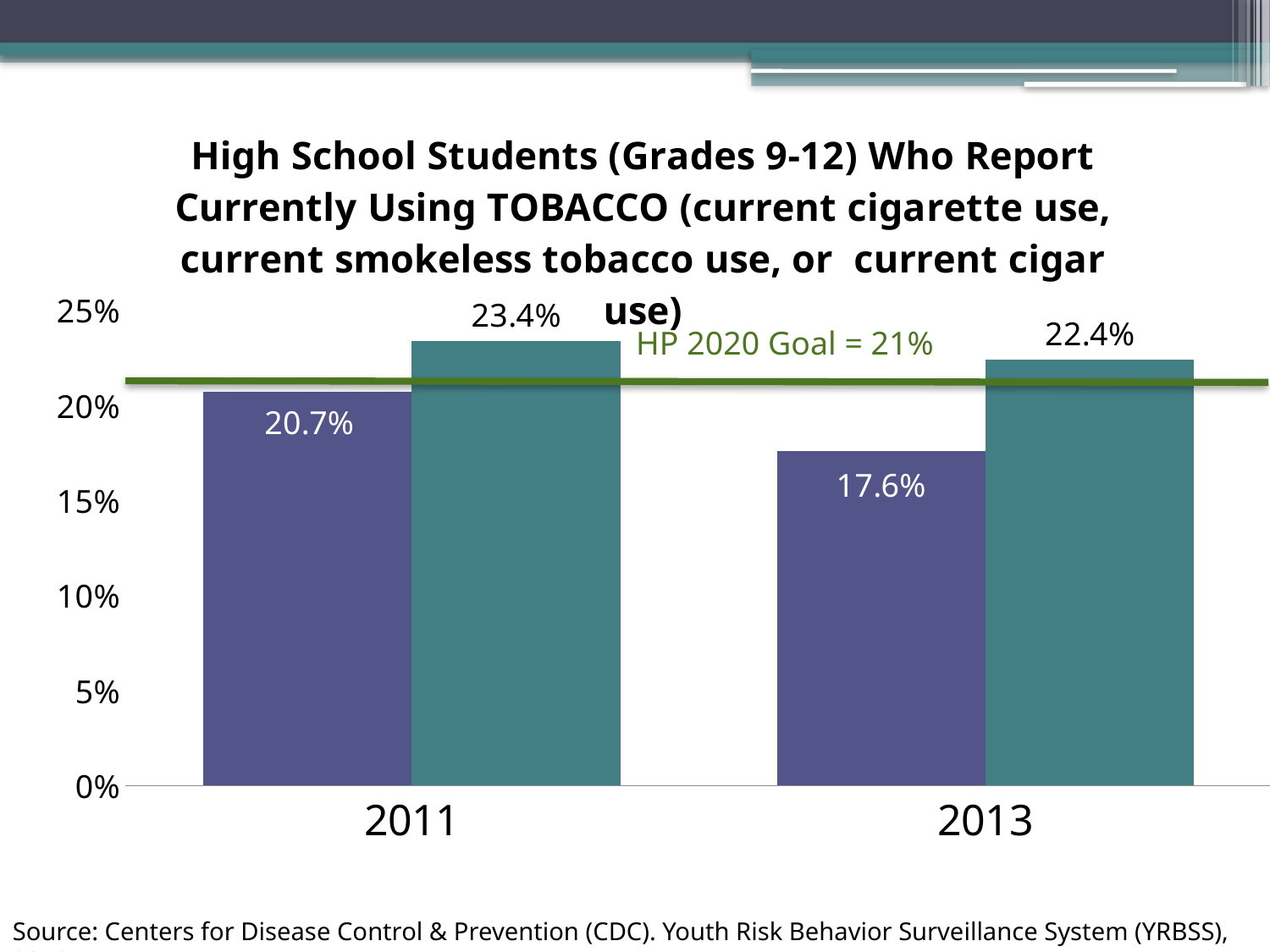
Which bar has the highest value on the chart? The teal bar for 2011 (23.4%) What is the difference between the teal and purple bars for 2013? 4.8% Which is larger, the purple bar for 2011 or the purple bar for 2013? The purple bar for 2011 What is the value of the purple bar for 2013? 17.6% What type of chart is shown on the slide? Bar chart What is the difference between the purple bar values for 2011 and 2013? 3.1% How many years are shown on the x axis? 2 What is the value of the purple bar for 2011? 20.7% Which bar has the lowest value on the chart? The purple bar for 2013 (17.6%) What is the HP 2020 Goal value marked by the green line on the chart? 21% What is the value of the teal bar for 2011? 23.4% What is the value of the teal bar for 2013? 22.4%